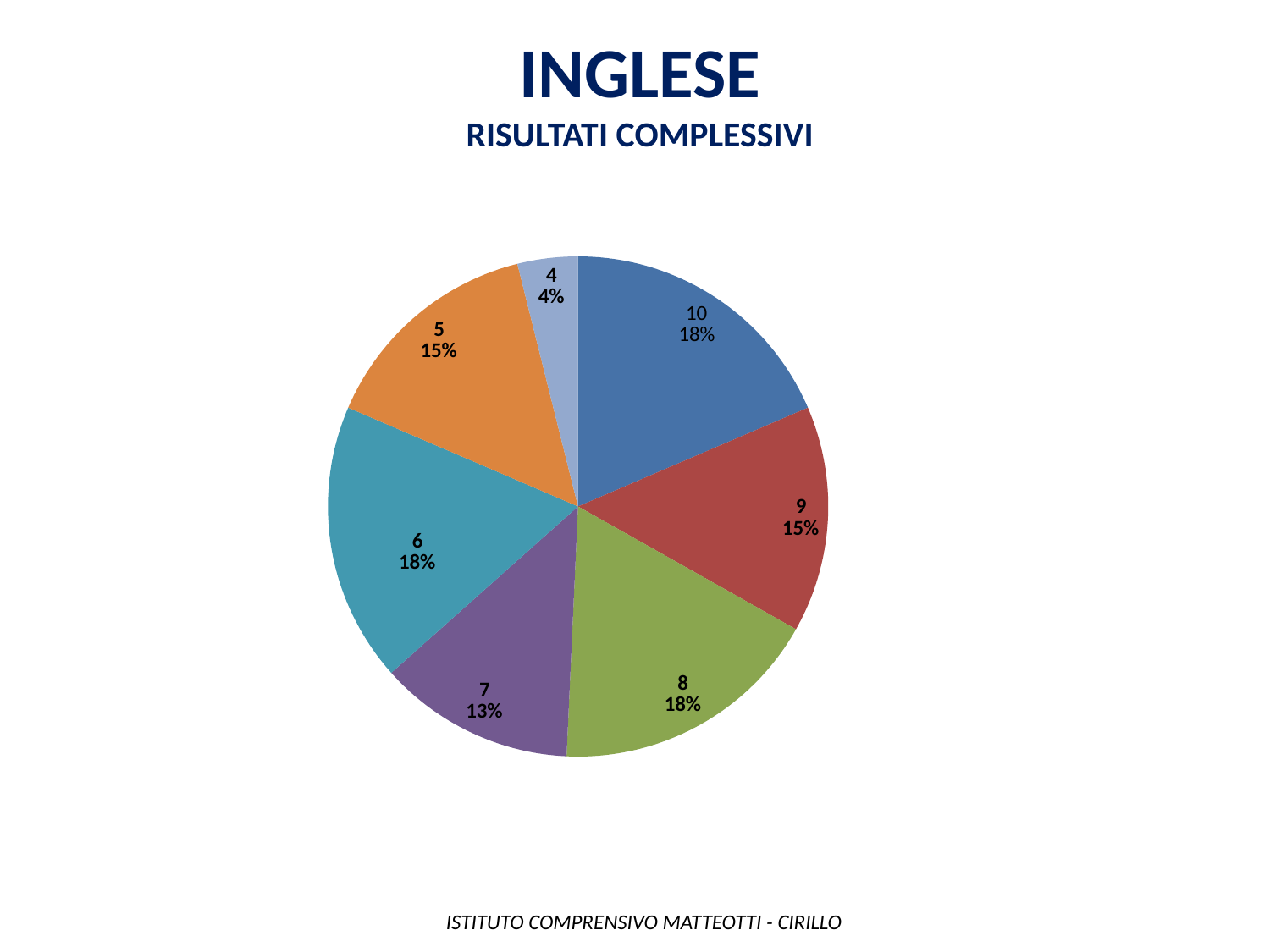
What share of the pie does grade 9 represent? 15% What is the title of the chart on the slide? INGLESE RISULTATI COMPLESSIVI What is the difference in percentage points between the slice for grade 9 and the slice for grade 4? 11 How many slices does the pie chart have? 7 What is the difference in percentage points between the slice for grade 6 and the slice for grade 7? 5 Which slice is larger, grade 7 or grade 8? 8 What share of the pie does grade 7 represent? 13% What share of the pie does grade 10 represent? 18% What type of chart is shown on the slide? pie chart Which grade has the smallest slice of the pie? 4